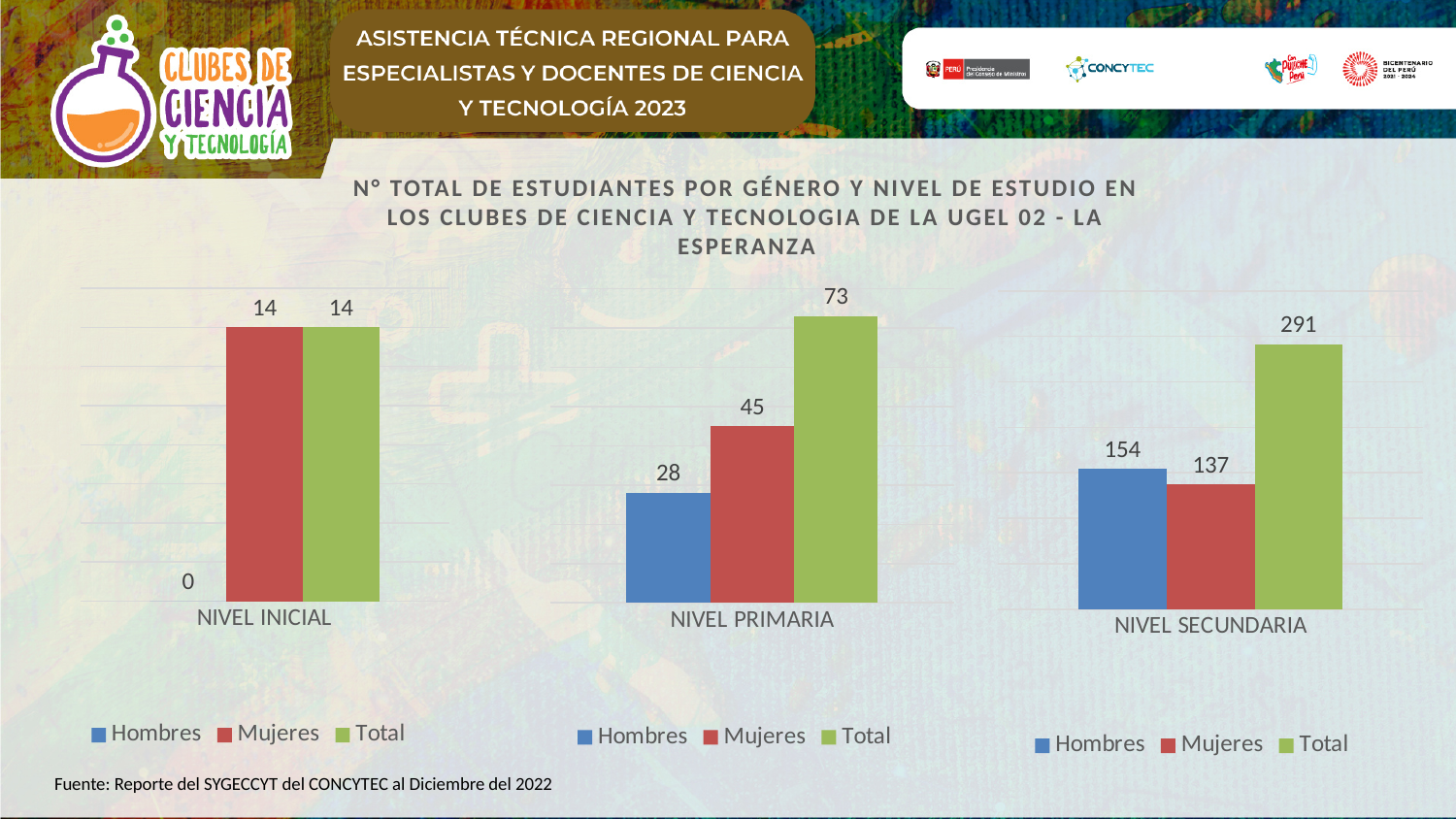
In the NIVEL SECUNDARIA chart on the right, what is the difference between Hombres and Mujeres? 17 In the NIVEL SECUNDARIA chart on the right, what is the Total value? 291 In the NIVEL SECUNDARIA chart on the right, what is the value for Hombres? 154 In the NIVEL INICIAL chart on the left, what is the value for Hombres? 0 What kind of chart is the NIVEL SECUNDARIA chart on the right? Bar chart In the NIVEL PRIMARIA chart in the middle, what is the difference between Mujeres and Hombres? 17 How many series does the legend of the NIVEL PRIMARIA chart list? 3 In the NIVEL PRIMARIA chart in the middle, what is the Total value? 73 In the NIVEL INICIAL chart on the left, what is the value for Mujeres? 14 In the NIVEL PRIMARIA chart in the middle, what is the value for Mujeres? 45 In the NIVEL SECUNDARIA chart on the right, which is larger, Hombres or Mujeres? Hombres In the NIVEL PRIMARIA chart in the middle, which series has the lowest value? Hombres